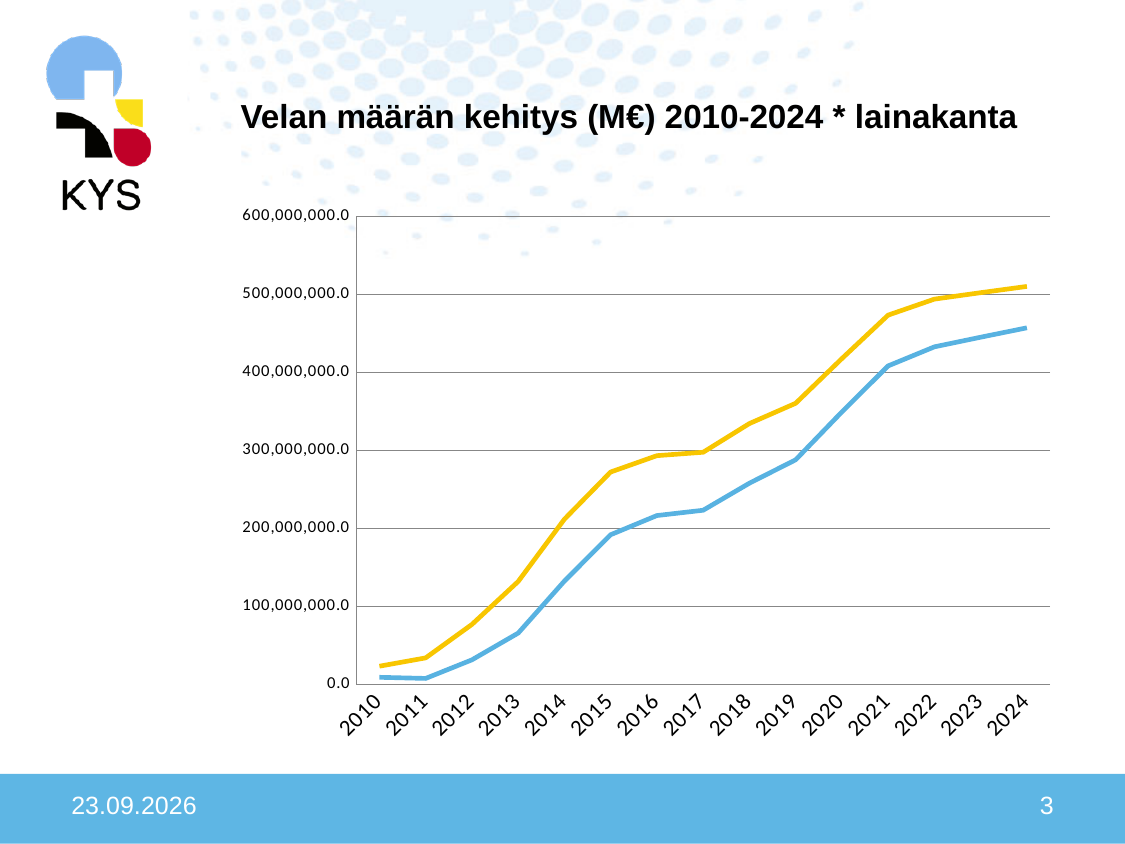
What kind of chart is shown on the slide? line chart Is the value of the blue line in 2013 greater or less than 100,000,000.0? less In 2016, which line has the higher value, the yellow line or the blue line? yellow line Do the values of the blue line rise or fall from 2010 to 2024? rise How many years are shown on the x axis of the chart? 15 Is the value of the blue line in 2024 greater or less than 500,000,000.0? less In which year does the yellow line reach its highest value? 2024 Is the value of the yellow line in 2021 greater or less than 400,000,000.0? greater What is the title of the chart? Velan määrän kehitys (M€) 2010-2024 * lainakanta How many lines are plotted on the chart? 2 Do the values of the yellow line rise or fall from 2010 to 2024? rise